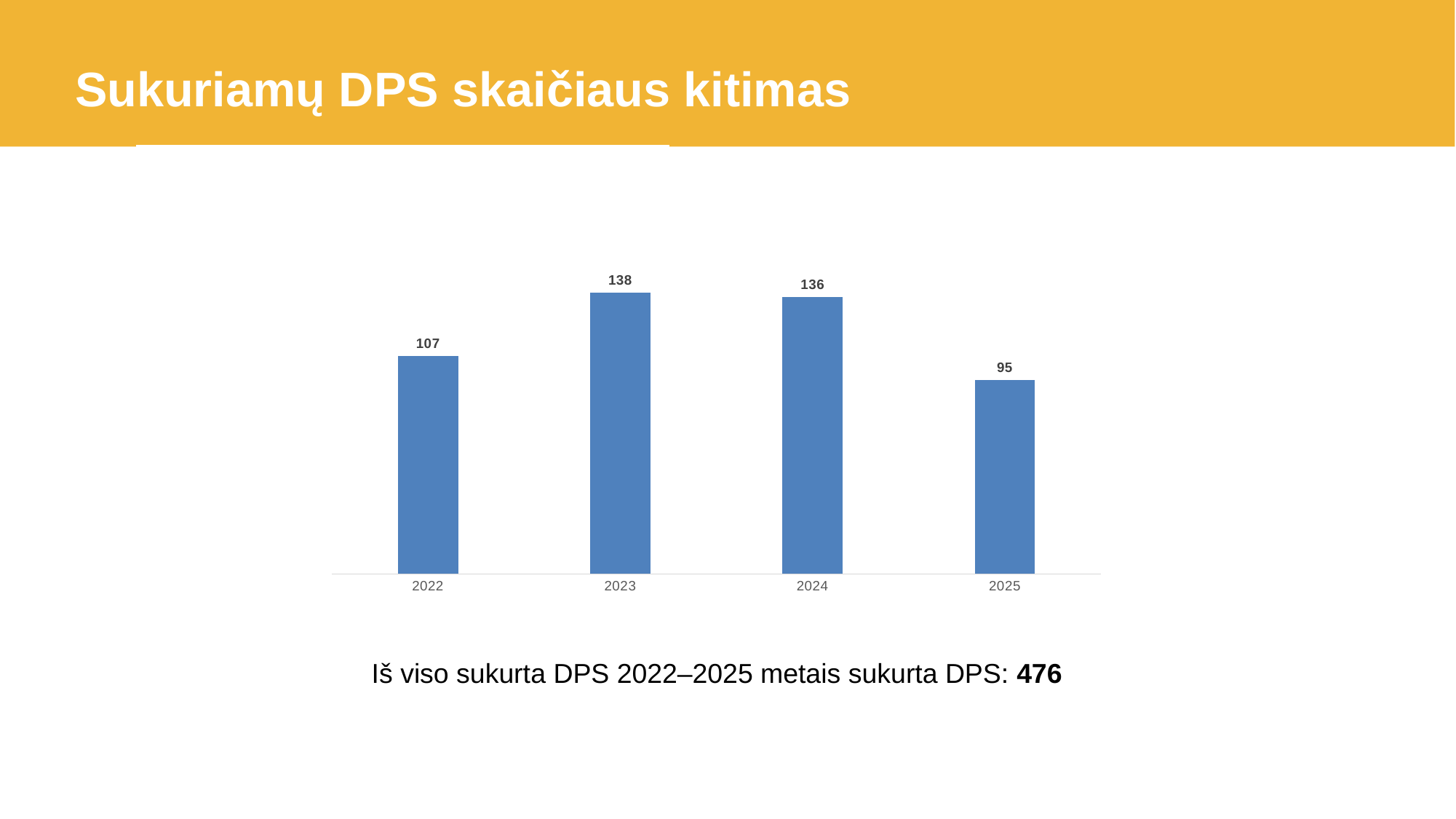
What is the difference between the values for 2022 and 2024? 29 What is the title of the slide? Sukuriamų DPS skaičiaus kitimas Which year has the highest value? 2023 Which is larger, the value for 2022 or the value for 2025? 2022 What is the value for 2025? 95 What kind of chart is shown on the slide? Bar chart What is the value for 2024? 136 What is the difference between the values for 2023 and 2025? 43 Which year has the lowest value? 2025 What is the value for 2022? 107 How many years are shown on the chart? 4 What is the value for 2023? 138